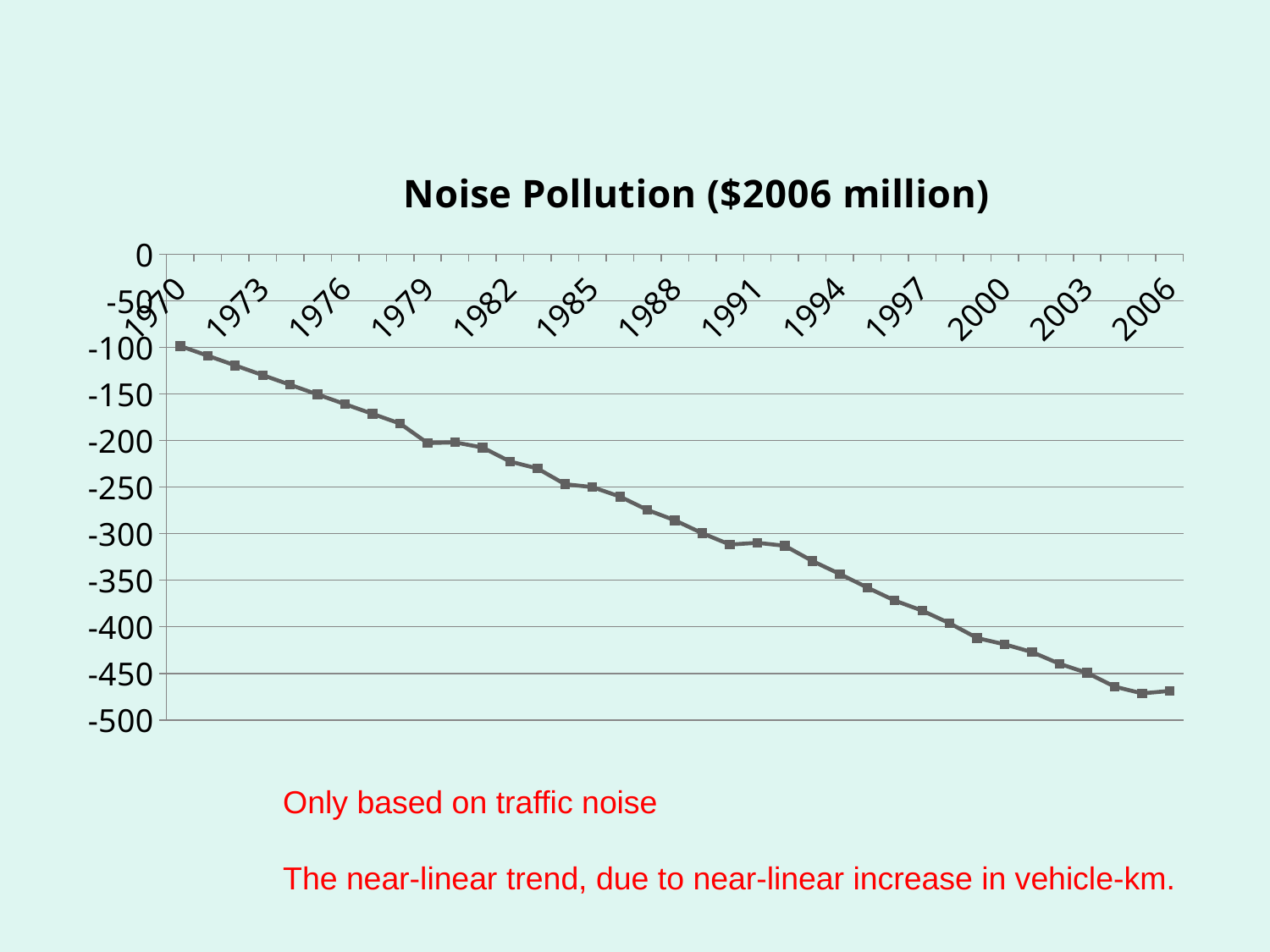
Do the plotted values rise or fall as the years go from 1970 to 2006? fall Is the value for 1976 above or below -150 on the axis? below What kind of chart is shown on the slide? line chart What is the title of the chart? Noise Pollution ($2006 million) Is the value for 2006 above or below -500 on the axis? above Which labelled year on the x axis has the highest (least negative) value? 1970 What is the lowest value shown on the y axis? -500 Is the value for 1991 above or below -300 on the axis? below How many year labels are shown on the x axis? 13 Which year has the larger (less negative) value, 1973 or 1997? 1973